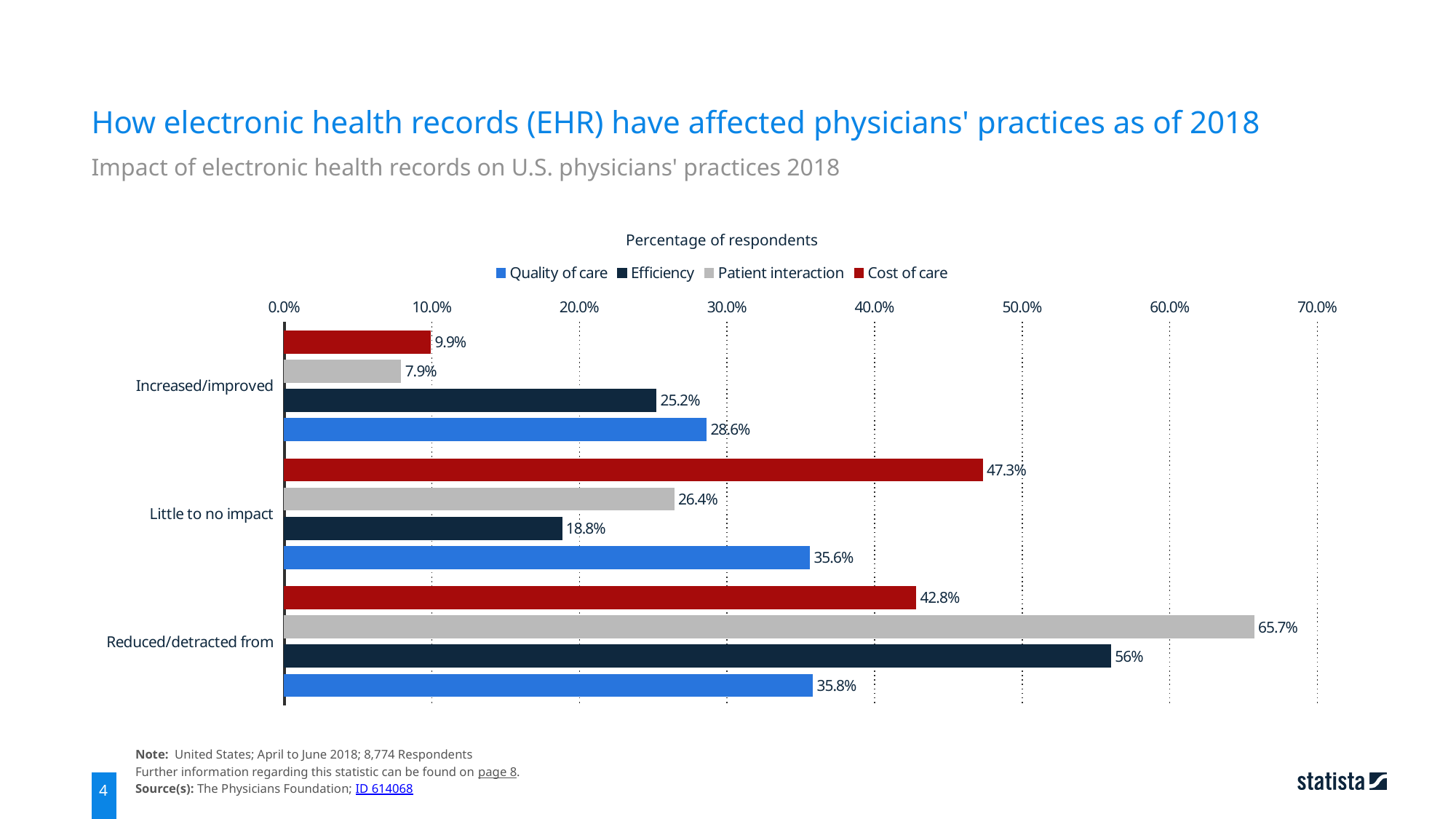
What percentage of respondents said EHR increased/improved quality of care? 28.6% Is the value for Cost of care in the Reduced/detracted from category greater or less than 40.0%? greater Which series has the lowest value in the Increased/improved category? Patient interaction Which series has the highest value in the Reduced/detracted from category? Patient interaction What is the difference between the Efficiency and Quality of care values in the Increased/improved category? 3.4% What kind of chart is shown on the slide? Bar chart How many categories are shown on the vertical axis? 3 How many series does the legend list? 4 In the Little to no impact category, which is larger: Quality of care or Patient interaction? Quality of care What is the value for Efficiency in the Reduced/detracted from category? 56% What is the value for Patient interaction in the Reduced/detracted from category? 65.7% What is the value for Cost of care in the Little to no impact category? 47.3%